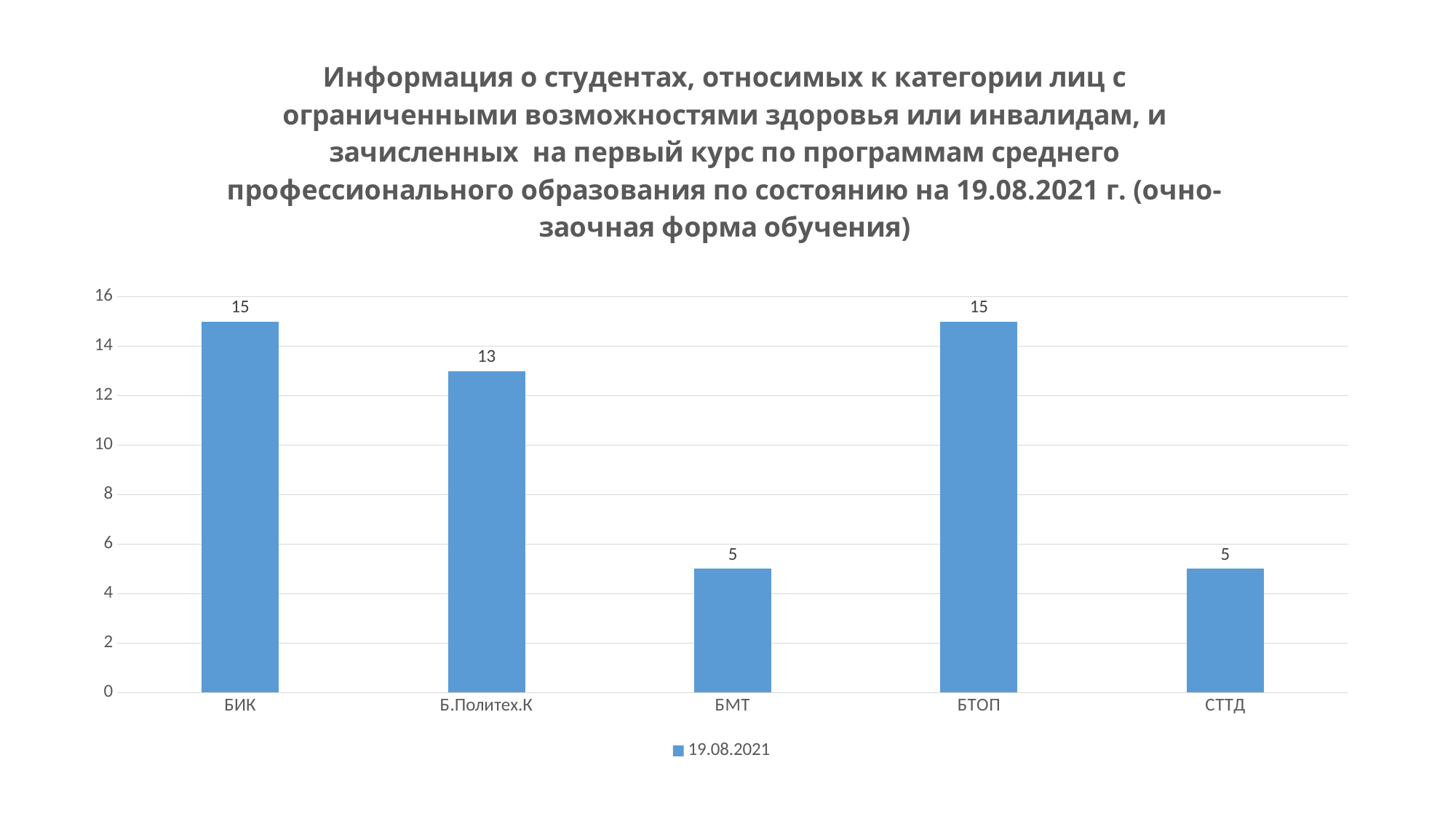
Which is larger, the value for Б.Политех.К or the value for БМТ? Б.Политех.К How many categories are shown on the x axis? 5 What is the value for БИК? 15 What kind of chart is shown on the slide? bar chart What is the value for БМТ? 5 What is the value for Б.Политех.К? 13 What is the difference between the values for БИК and Б.Политех.К? 2 What is the value for СТТД? 5 Which category has the lowest value, Б.Политех.К or БМТ? БМТ What is the difference between the values for БТОП and СТТД? 10 How many series does the legend list? 1 Is the value for Б.Политех.К greater or less than 10? greater